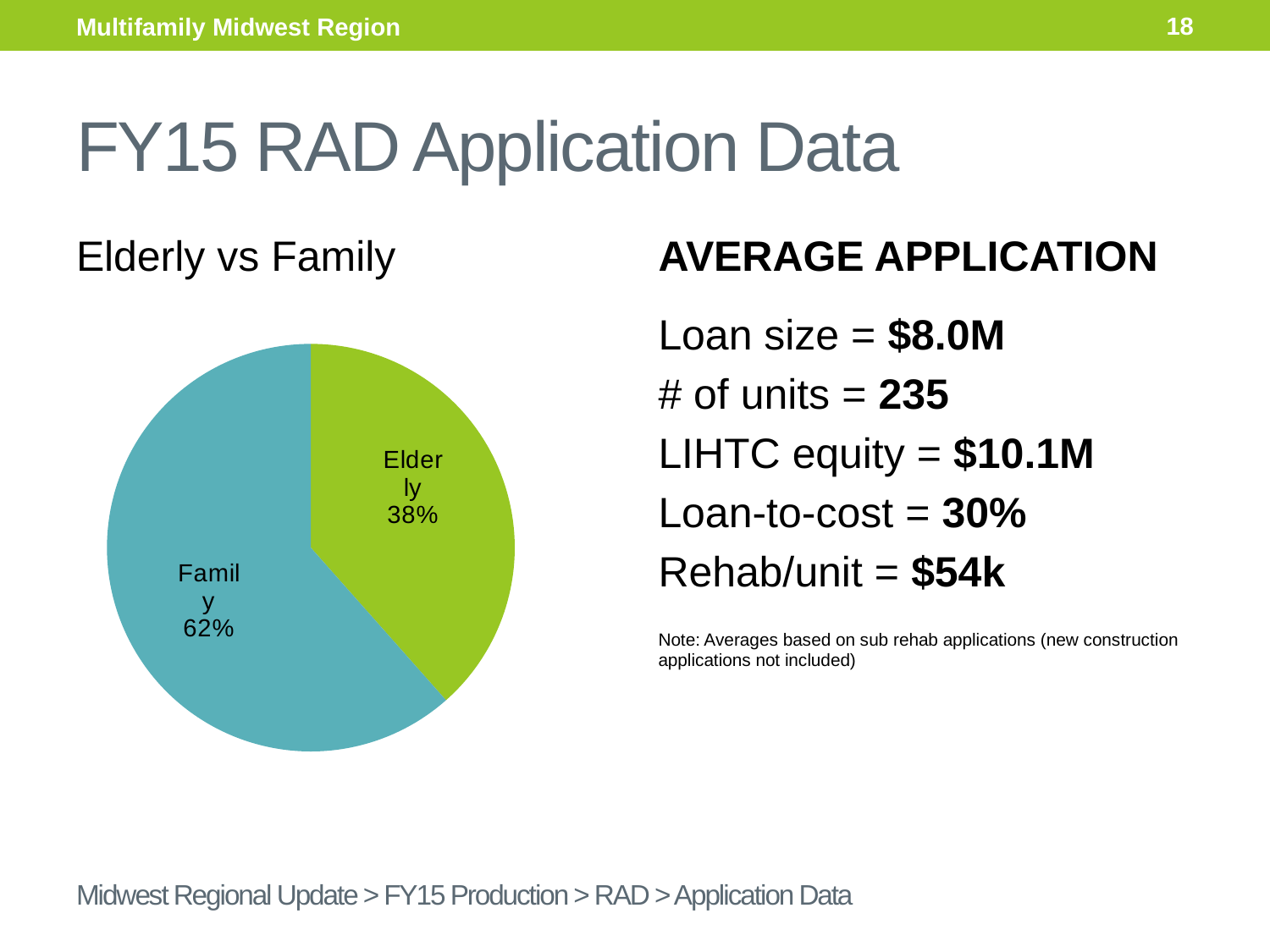
What is the difference in percentage points between the Family and Elderly slices? 24 What share of the pie chart does the Elderly slice represent? 38% What is the title of the chart on the slide? Elderly vs Family What kind of chart is shown on the slide? Pie chart What colour is the Family slice in the pie chart? Teal How many slices does the pie chart have? 2 Is the Elderly share of the pie greater or less than 50%? less Which category has the smallest slice in the pie chart? Elderly Which category has the largest slice in the pie chart? Family Which slice is larger, Elderly or Family? Family What share of the pie chart does the Family slice represent? 62%